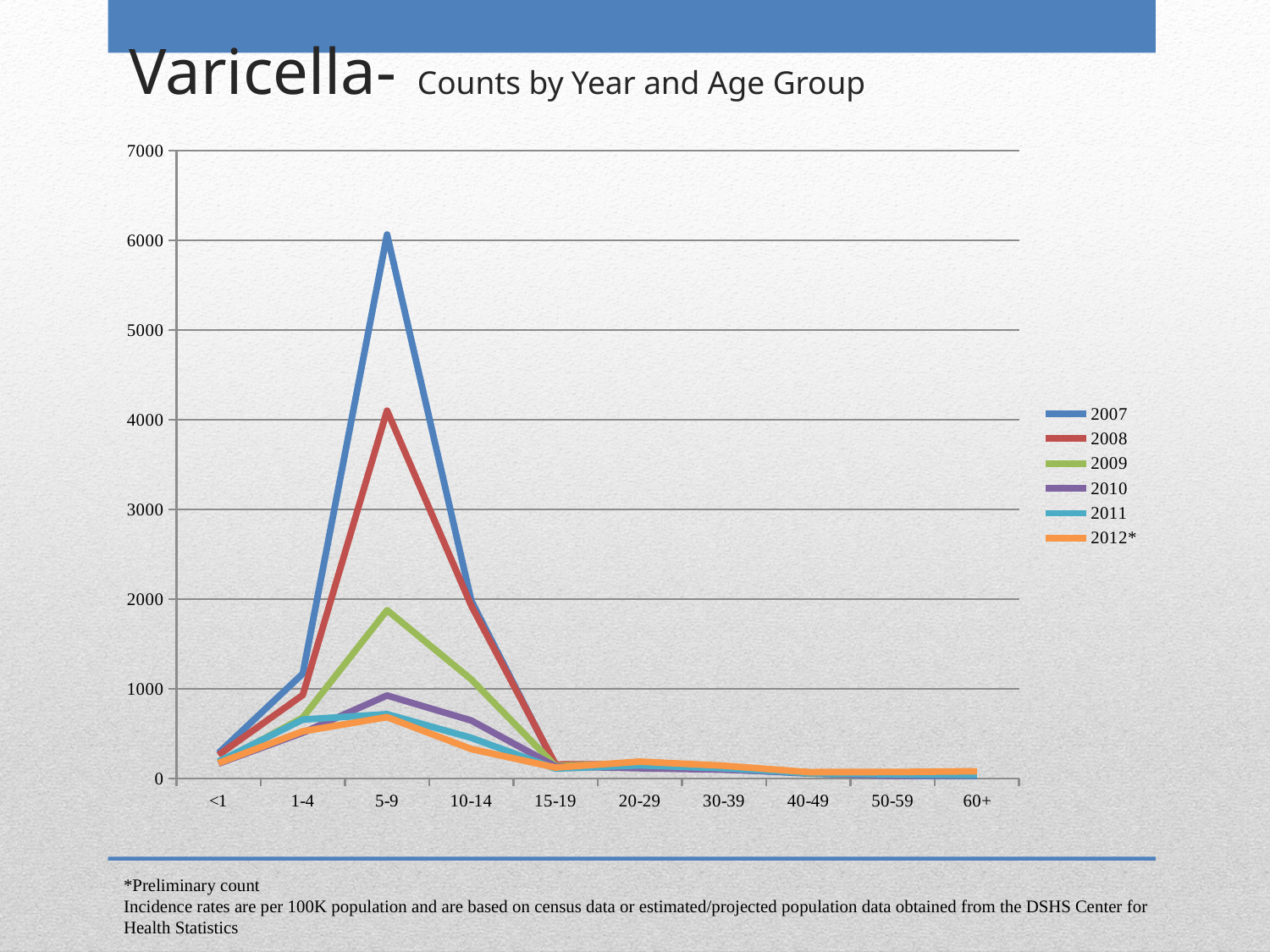
How many series does the legend list? 6 At the 5-9 age group, which is larger: the 2009 value or the 2010 value? 2009 Is the 2010 value for the 5-9 age group greater or less than 1000? less For the 2007 series, which age group has the highest count? 5-9 Which year's series reaches the highest peak on the chart? 2007 Is the 2009 value for the 5-9 age group greater or less than 2000? less Which legend entry is marked with an asterisk? 2012* Is the 2007 value for the 5-9 age group greater or less than 5000? greater What kind of chart is shown on the slide? line chart At the 5-9 age group, which is larger: the 2007 value or the 2008 value? 2007 How many age groups are shown on the x axis? 10 Does the 2007 series rise or fall from the 5-9 age group to the 15-19 age group? fall